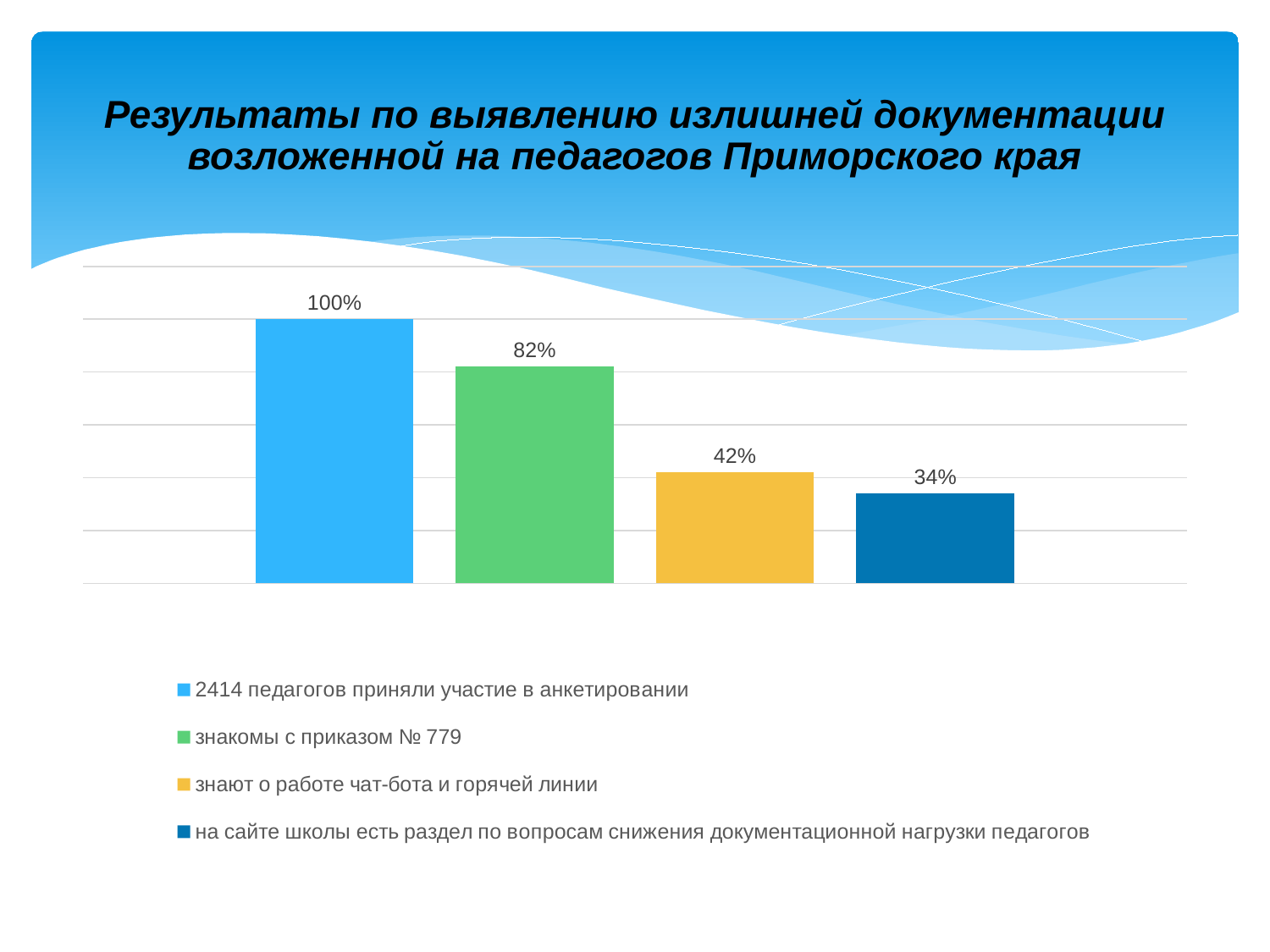
What value is shown for the bar "на сайте школы есть раздел по вопросам снижения документационной нагрузки педагогов"? 34% What value is shown for the bar "знают о работе чат-бота и горячей линии"? 42% What is the difference between the value for "знакомы с приказом № 779" and the value for "знают о работе чат-бота и горячей линии"? 40% What colour is the bar for "знают о работе чат-бота и горячей линии"? Yellow What value is shown for the bar "знакомы с приказом № 779"? 82% Which is larger: the value for "знакомы с приказом № 779" or the value for "знают о работе чат-бота и горячей линии"? знакомы с приказом № 779 What is the difference between the value for "знают о работе чат-бота и горячей линии" and the value for "на сайте школы есть раздел по вопросам снижения документационной нагрузки педагогов"? 8% Which legend entry has the lowest value in the chart? на сайте школы есть раздел по вопросам снижения документационной нагрузки педагогов What value is shown for the bar "2414 педагогов приняли участие в анкетировании"? 100% How many bars are plotted in the chart? 4 Which legend entry has the highest value in the chart? 2414 педагогов приняли участие в анкетировании What kind of chart is shown on the slide? Bar chart